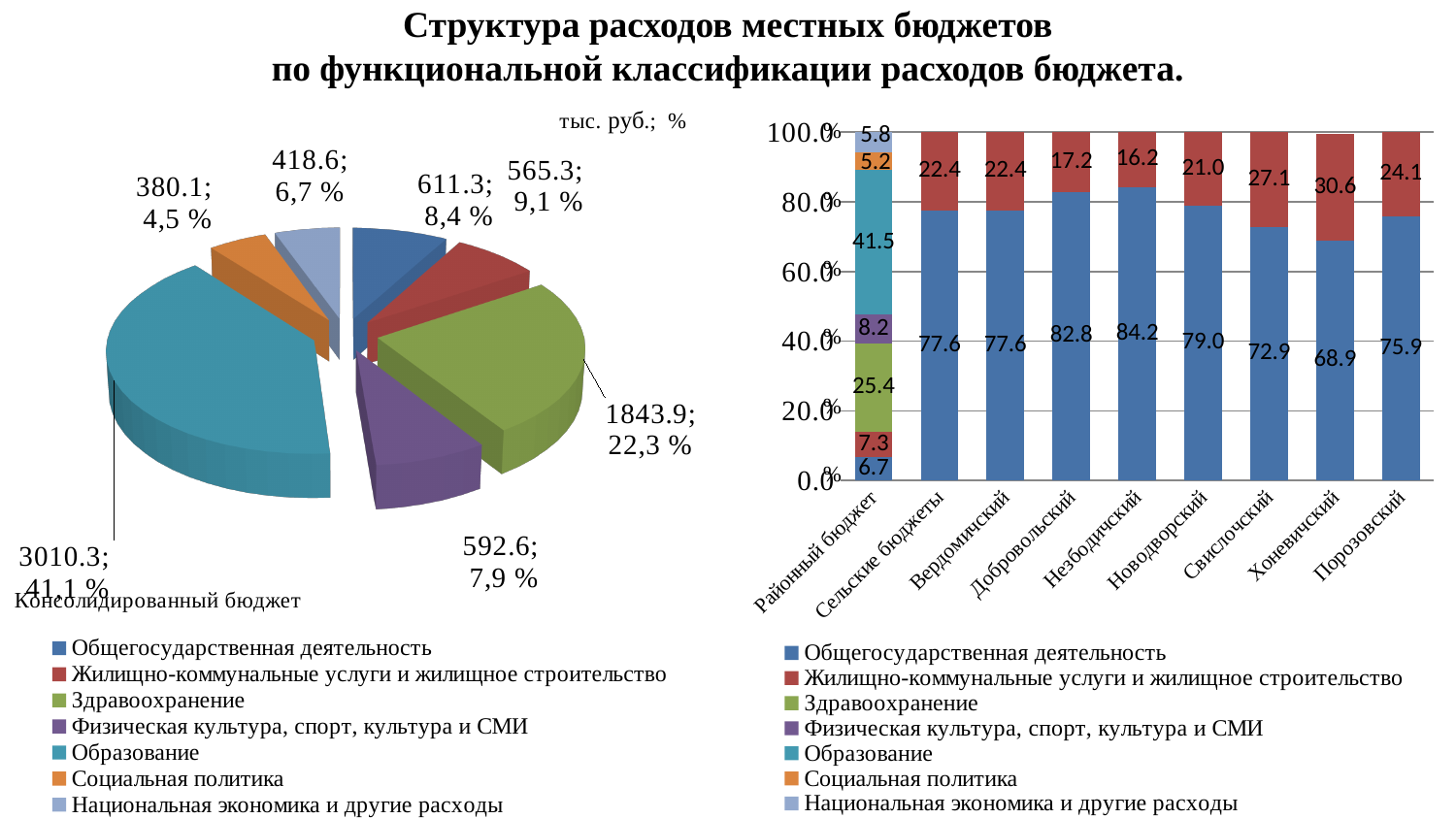
In the bar chart on the right, how many categories are shown on the x axis? 9 In the pie chart on the left, what is the difference in thousand rubles between the Здравоохранение slice (1843.9) and the Общегосударственная деятельность slice (611.3)? 1232.6 What kind of chart is on the right side of the slide? Stacked bar chart In the bar chart on the right, what is the value of Общегосударственная деятельность for Незбодичский? 84.2 In the bar chart on the right, what is the value of Образование for Районный бюджет? 41.5 In the bar chart on the right, which budget has the highest value for Общегосударственная деятельность? Незбодичский In the bar chart on the right, what is the value of Жилищно-коммунальные услуги и жилищное строительство for Хоневичский? 30.6 In the pie chart on the left, what value is shown for the Образование slice? 3010.3; 41,1 % In the pie chart on the left, which category has the smallest slice? Социальная политика In the pie chart on the left, what percentage share does the Здравоохранение slice have? 22,3 % In the pie chart on the left, which category has the largest slice? Образование In the pie chart on the left, how many slices are there? 7